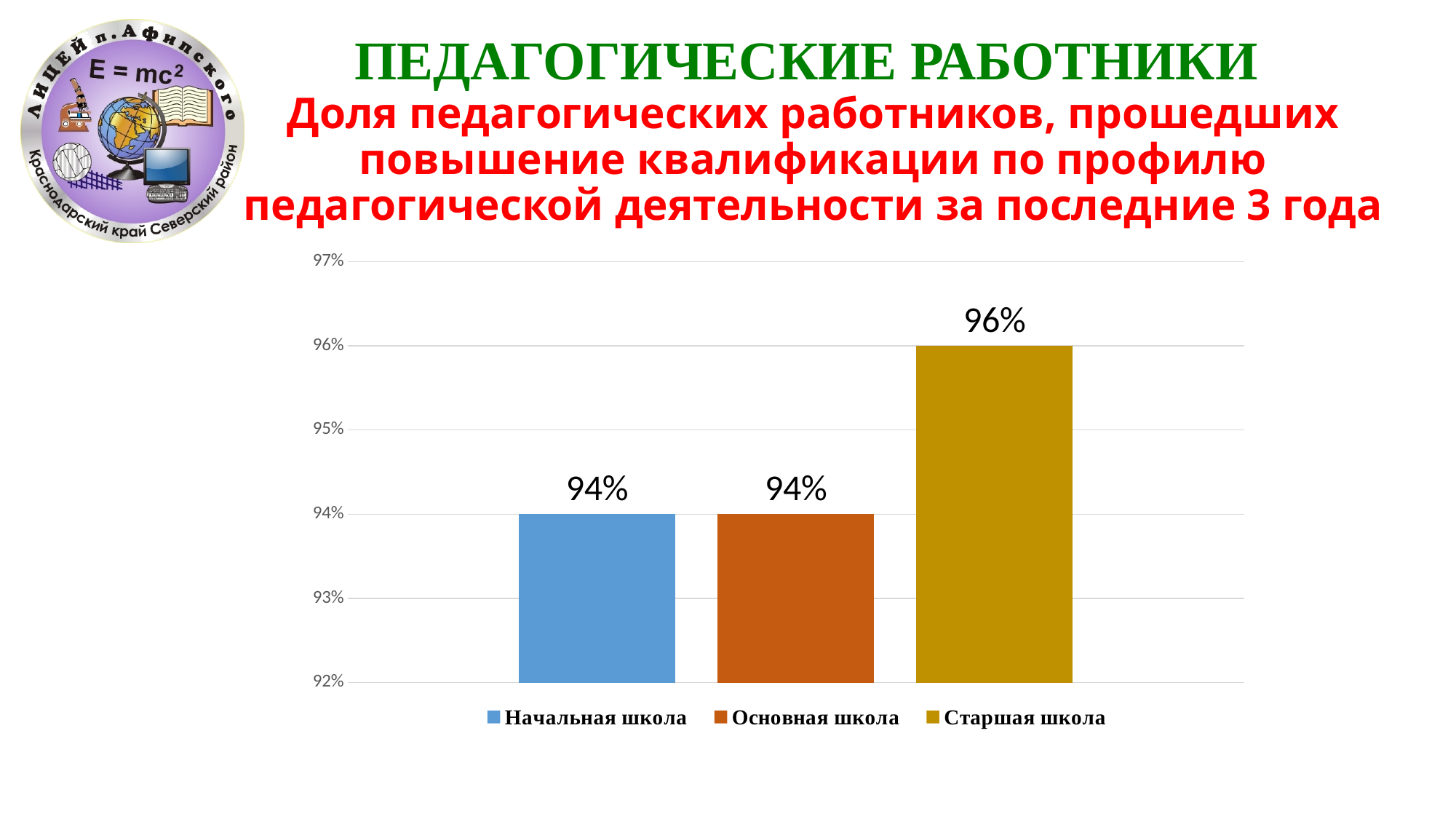
Which category has the highest value? Старшая школа What is the value for Старшая школа? 96% Is the value for Старшая школа greater or less than 95%? greater Which is larger, the value for Старшая школа or the value for Основная школа? Старшая школа What colour is the bar for Старшая школа? gold What is the value for Начальная школа? 94% What is the value for Основная школа? 94% How many entries does the legend list? 3 What kind of chart is shown on the slide? bar chart Is the value for Начальная школа greater or less than 95%? less How many bars are plotted in the chart? 3 What is the difference between the values for Старшая школа and Начальная школа? 2%